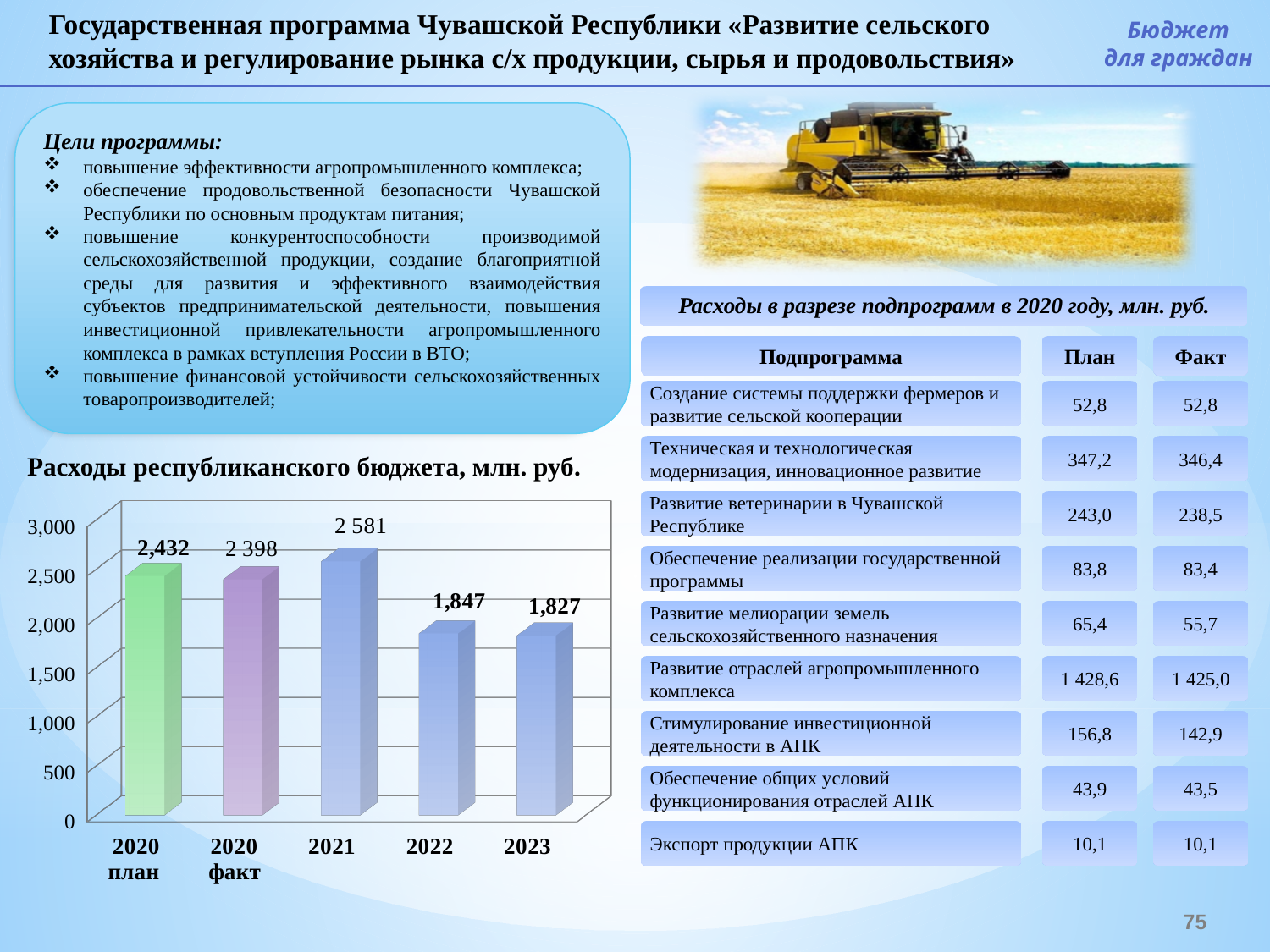
In the chart «Расходы республиканского бюджета, млн. руб.», what is the value for 2021? 2 581 In the chart «Расходы республиканского бюджета, млн. руб.», do the values rise or fall from 2021 to 2023? fall In the chart «Расходы республиканского бюджета, млн. руб.», what is the value for 2020 план? 2,432 In the chart «Расходы республиканского бюджета, млн. руб.», what is the value for 2020 факт? 2 398 In the chart «Расходы республиканского бюджета, млн. руб.», which category has the highest value? 2021 How many bars are plotted in the chart «Расходы республиканского бюджета, млн. руб.»? 5 In the chart «Расходы республиканского бюджета, млн. руб.», what is the difference between the 2022 value and the 2023 value? 20 In the chart «Расходы республиканского бюджета, млн. руб.», what is the difference between the 2021 value and the 2020 факт value? 183 What type of chart is shown under the title «Расходы республиканского бюджета, млн. руб.»? bar chart In the chart «Расходы республиканского бюджета, млн. руб.», what is the value for 2023? 1,827 In the chart «Расходы республиканского бюджета, млн. руб.», which is larger: the value for 2021 or the value for 2022? 2021 In the chart «Расходы республиканского бюджета, млн. руб.», which category has the lowest value? 2023